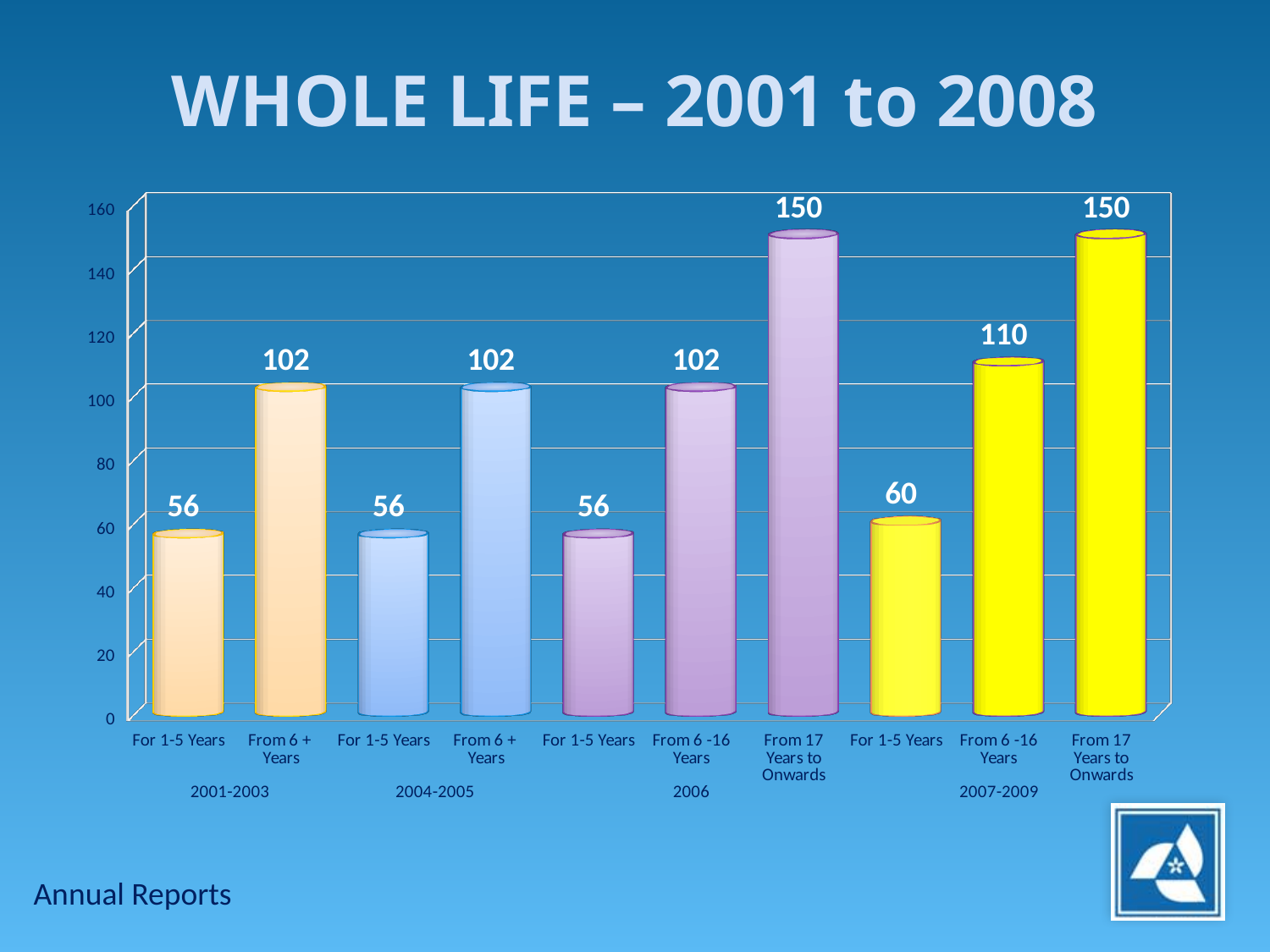
What is the title of the chart on the slide? WHOLE LIFE – 2001 to 2008 What is the lowest value shown on the chart? 56 Which is larger: 'For 1-5 Years' in 2007-2009 or 'For 1-5 Years' in 2006? For 1-5 Years in 2007-2009 What is the value for 'For 1-5 Years' in the 2007-2009 group? 60 What is the value for 'From 17 Years to Onwards' in the 2006 group? 150 What is the highest value shown on the chart? 150 What is the value for 'For 1-5 Years' in the 2001-2003 group? 56 What is the difference between 'From 17 Years to Onwards' and 'From 6 -16 Years' in the 2007-2009 group? 40 What kind of chart is shown on the slide? Bar chart What is the value for 'From 6 + Years' in the 2004-2005 group? 102 How many bars are plotted on the chart? 10 What is the value for 'From 6 -16 Years' in the 2007-2009 group? 110